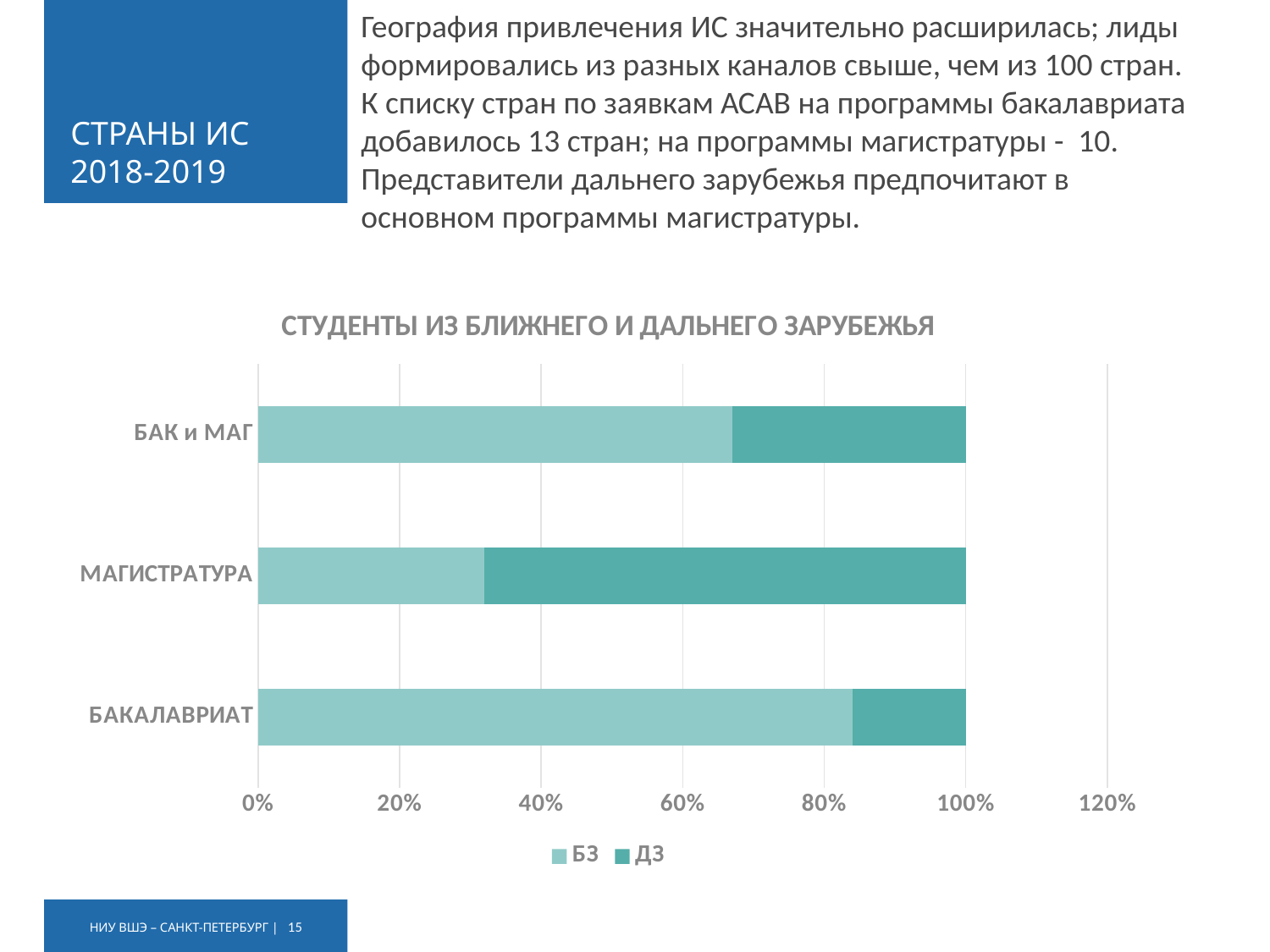
How many series does the legend list? 2 Is the БЗ share for БАКАЛАВРИАТ greater or less than 80%? greater What is the total of the stacked bar for БАКАЛАВРИАТ? 100% Which category has the smallest БЗ share? МАГИСТРАТУРА What are the two series named in the legend? БЗ and ДЗ Which category has the largest БЗ share? БАКАЛАВРИАТ What is the title of the chart? СТУДЕНТЫ ИЗ БЛИЖНЕГО И ДАЛЬНЕГО ЗАРУБЕЖЬЯ In the МАГИСТРАТУРА bar, which series is larger, БЗ or ДЗ? ДЗ How many categories are shown on the chart? 3 What kind of chart is shown on the slide? stacked bar chart Is the БЗ share for МАГИСТРАТУРА greater or less than 40%? less Is the БЗ share for БАК и МАГ greater or less than 60%? greater